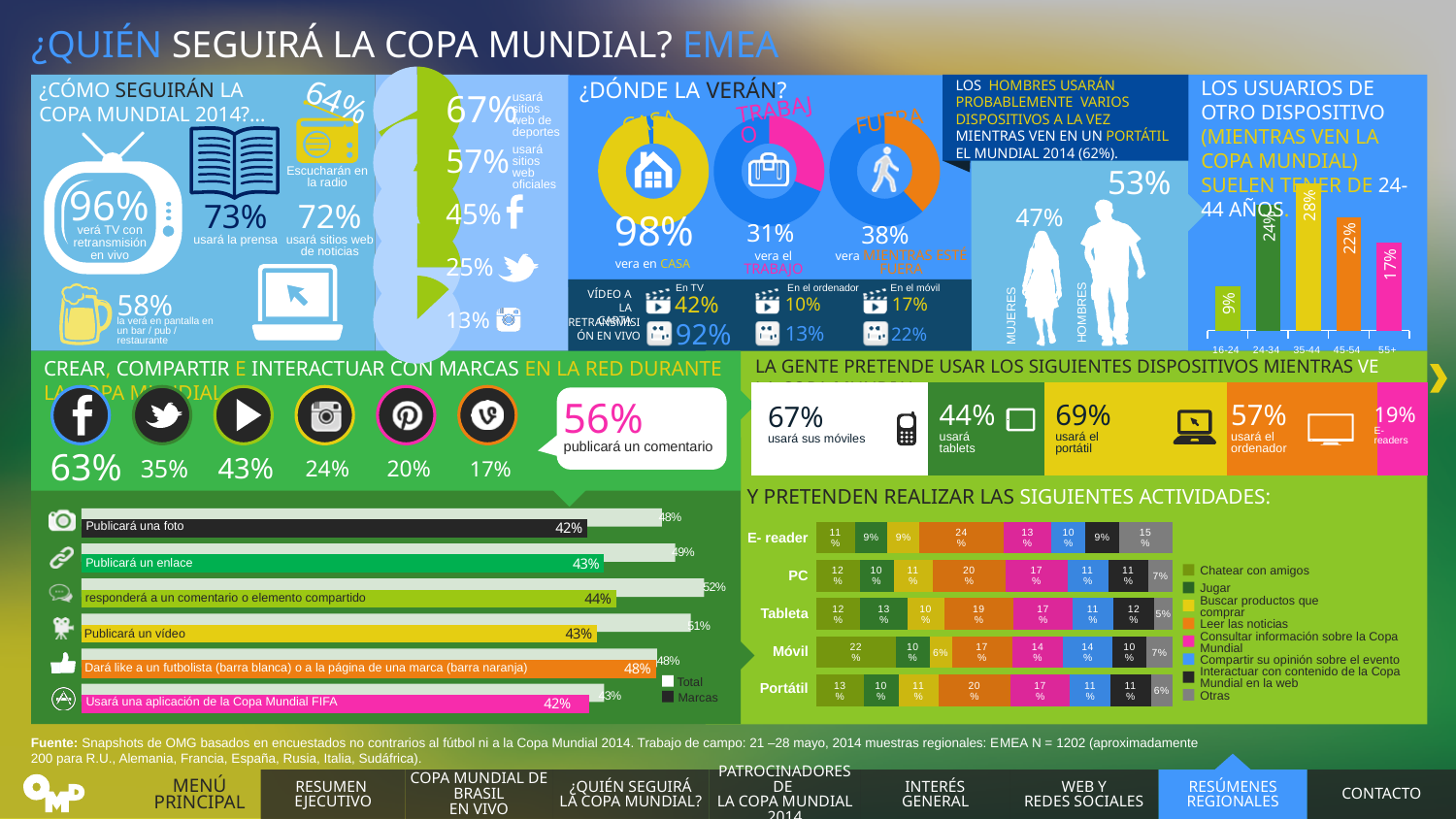
In the horizontal bar chart at the bottom left, which activity has the highest Total value? responderá a un comentario o elemento compartido In the age-group bar chart at the top right, what is the value for the 24-34 age group? 24% In the stacked bar chart at the bottom right, what is the 'Leer las noticias' value for E-reader? 24% In the age-group bar chart at the top right, which age group has the lowest value? 16-24 How many age groups are shown in the bar chart at the top right? 5 How many series does the legend of the horizontal bar chart at the bottom left list? 2 In the age-group bar chart at the top right, which age group has the highest value? 35-44 How many series does the legend of the stacked bar chart at the bottom right list? 8 In the horizontal bar chart at the bottom left, what is the Marcas value for 'Publicará una foto'? 42% In the horizontal bar chart at the bottom left, what is the Total value for 'responderá a un comentario o elemento compartido'? 52% In the age-group bar chart at the top right, what is the difference between the 35-44 and 16-24 values? 19 percentage points In the stacked bar chart at the bottom right, what is the 'Chatear con amigos' value for Móvil? 22%